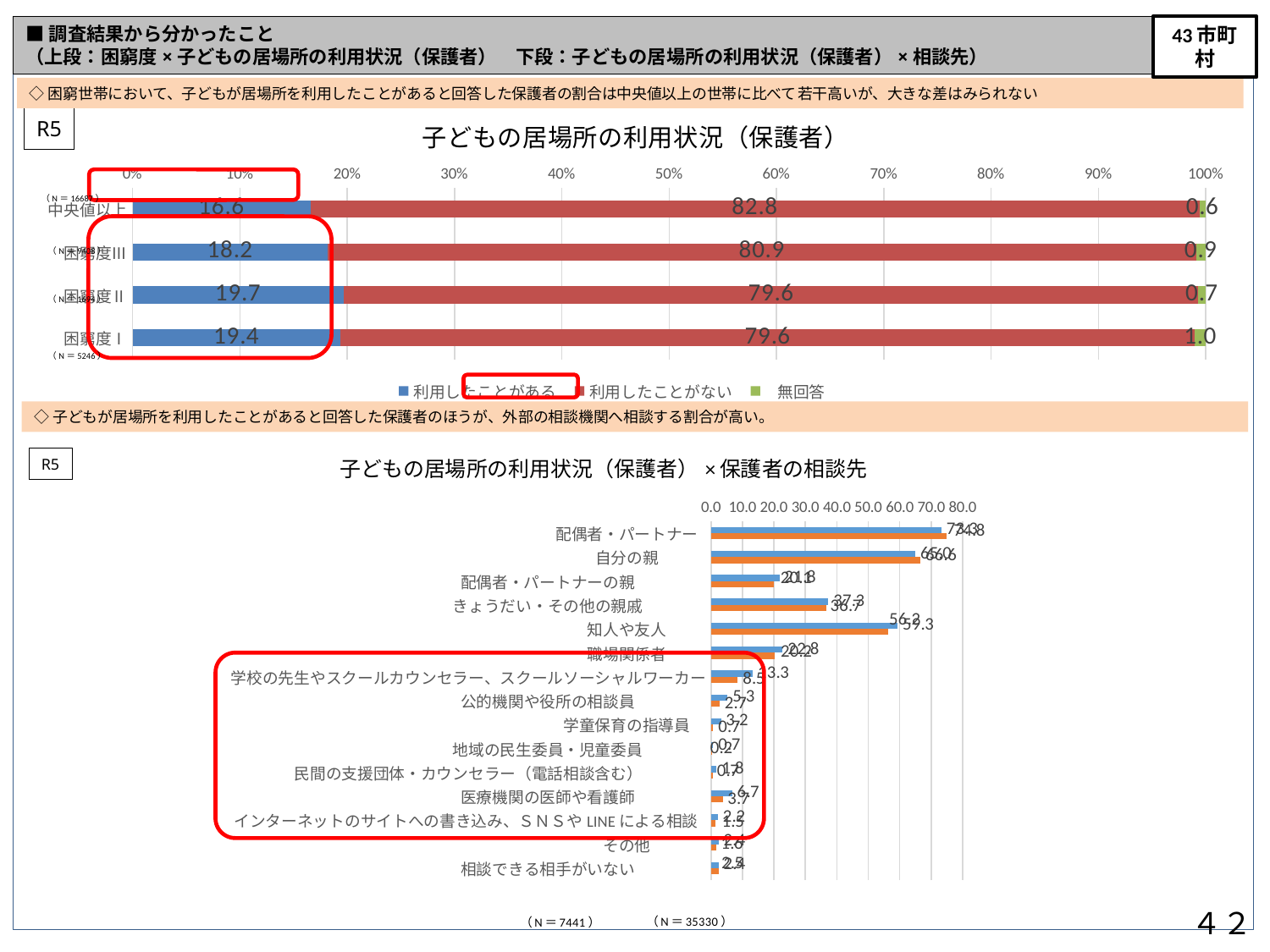
In the top chart 子どもの居場所の利用状況（保護者）, what is the value of 無回答 for 困窮度Ⅰ? 1.0 In the top chart 子どもの居場所の利用状況（保護者）, what is the value of 利用したことがない for 困窮度Ⅱ? 79.6 In the top chart 子どもの居場所の利用状況（保護者）, what is the difference between the 利用したことがある values for 困窮度Ⅱ and 中央値以上? 3.1 What kind of chart is the top chart 子どもの居場所の利用状況（保護者）? Stacked bar chart In the top chart 子どもの居場所の利用状況（保護者）, which category has the highest value for 利用したことがある? 困窮度Ⅱ In the top chart 子どもの居場所の利用状況（保護者）, how many series does the legend list? 3 In the top chart 子どもの居場所の利用状況（保護者）, which has the larger 利用したことがない value, 中央値以上 or 困窮度Ⅲ? 中央値以上 In the bottom chart 子どもの居場所の利用状況（保護者）×保護者の相談先, how many categories are listed? 15 In the top chart 子どもの居場所の利用状況（保護者）, how many categories are shown? 4 In the top chart 子どもの居場所の利用状況（保護者）, which category has the lowest value for 利用したことがある? 中央値以上 In the bottom chart 子どもの居場所の利用状況（保護者）×保護者の相談先, which category has the highest values? 配偶者・パートナー In the top chart 子どもの居場所の利用状況（保護者）, what is the value of 利用したことがある for 中央値以上? 16.6